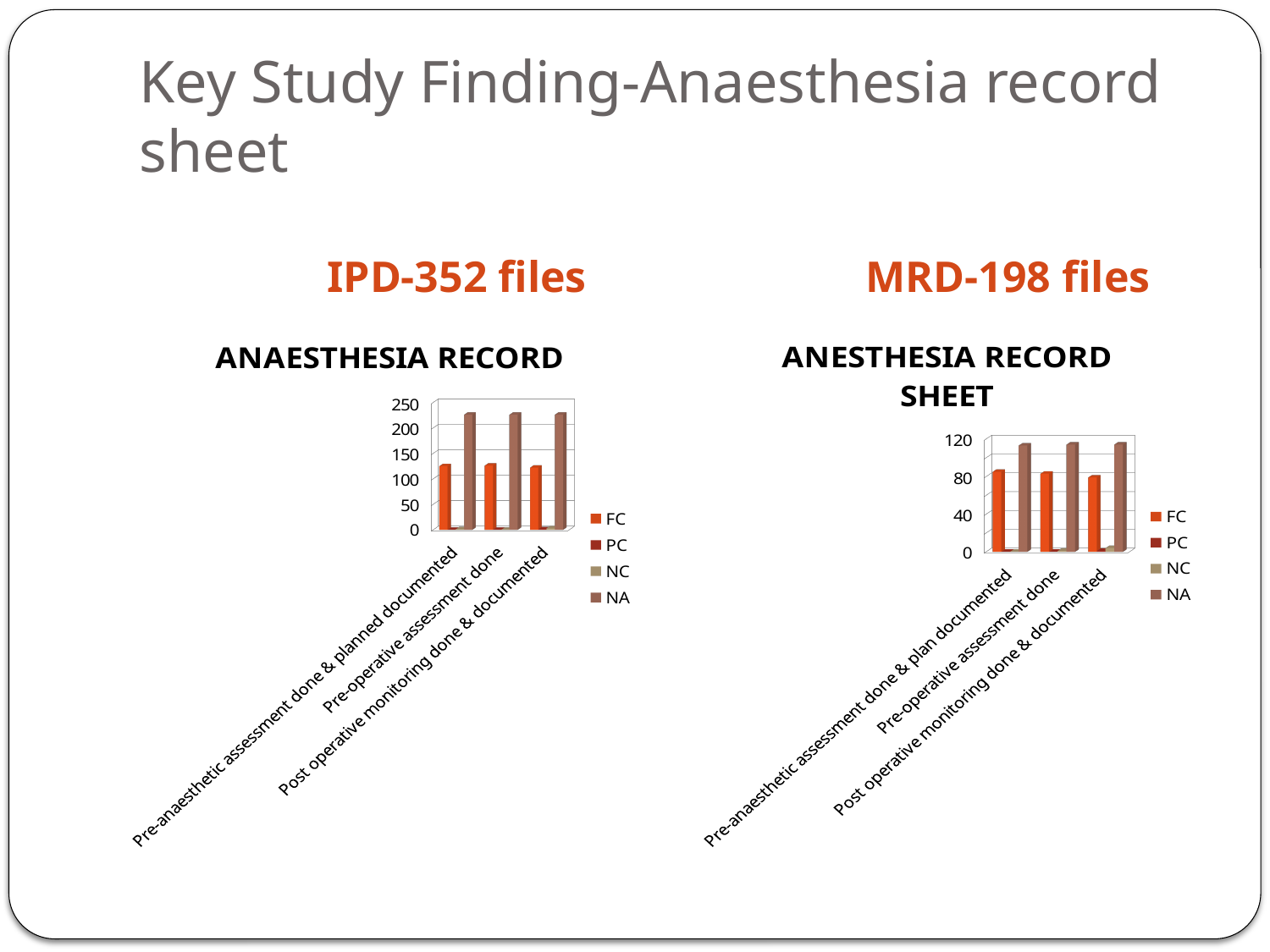
In the ANESTHESIA RECORD SHEET chart on the right, is the NA value for 'Pre-operative assessment done' greater or less than 80? greater In the ANAESTHESIA RECORD chart on the left, which series has the tallest bars across all categories? NA In the ANAESTHESIA RECORD chart on the left, is the NA value for 'Pre-operative assessment done' greater or less than 200? greater In the ANESTHESIA RECORD SHEET chart on the right, which series has the shortest bars? PC What is the title of the chart on the right? ANESTHESIA RECORD SHEET In the ANESTHESIA RECORD SHEET chart on the right, for 'Pre-anaesthetic assessment done & plan documented', which is larger: FC or NA? NA How many categories are shown on the x axis of the ANESTHESIA RECORD SHEET chart on the right? 3 How many series does the legend of the ANAESTHESIA RECORD chart on the left list? 4 In the ANAESTHESIA RECORD chart on the left, for 'Post operative monitoring done & documented', which is larger: FC or NA? NA In the ANAESTHESIA RECORD chart on the left, is the FC value for 'Pre-anaesthetic assessment done & planned documented' greater or less than 100? greater What type of chart is the ANAESTHESIA RECORD chart on the left? bar chart